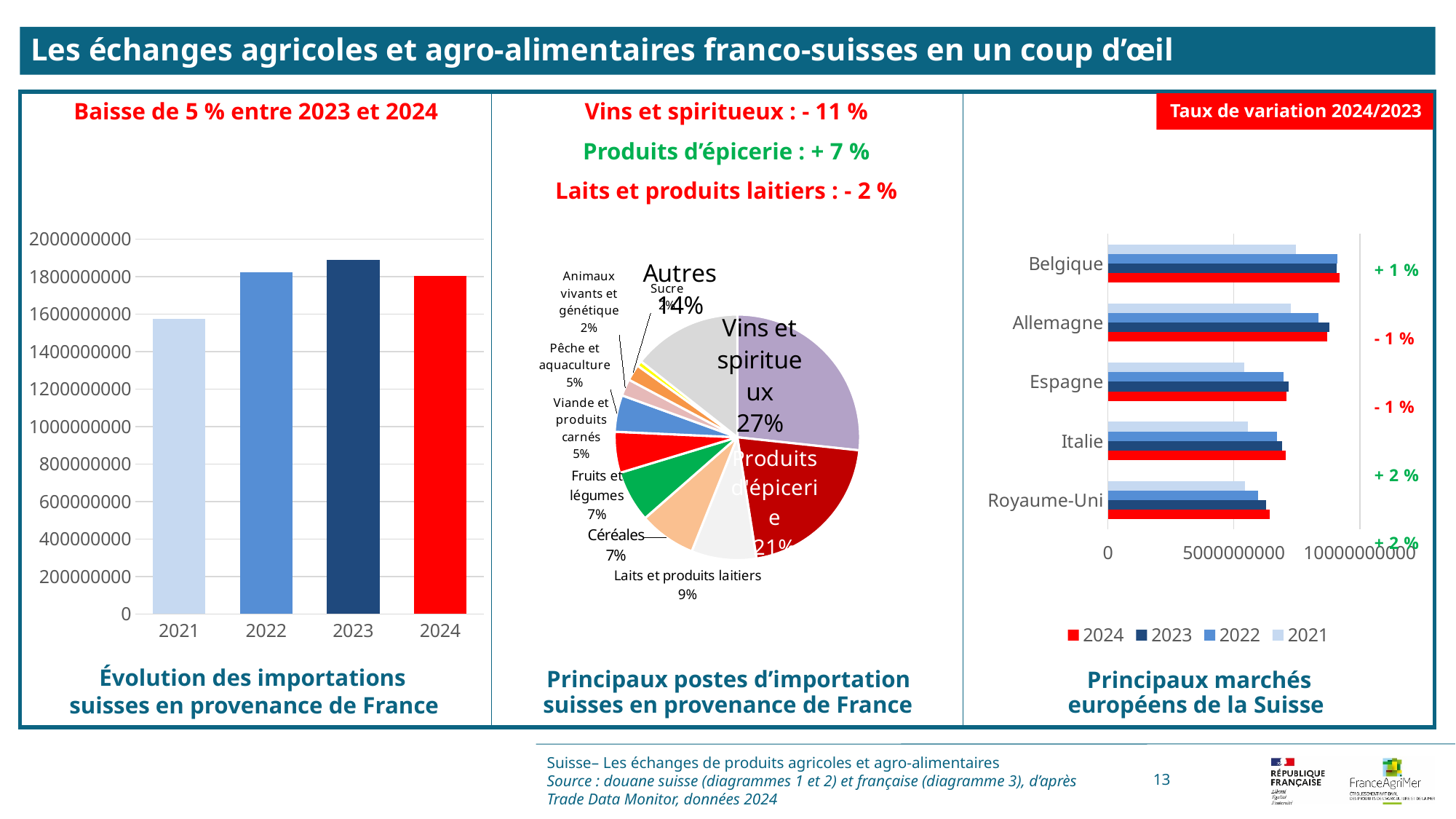
On the pie chart 'Principaux postes d'importation suisses en provenance de France', which slice is the largest? Vins et spiritueux On the chart 'Principaux marchés européens de la Suisse', is the 2024 value for Belgique greater or less than 5000000000? greater On the pie chart 'Principaux postes d'importation suisses en provenance de France', what share does 'Vins et spiritueux' have? 27% On the pie chart 'Principaux postes d'importation suisses en provenance de France', what is the difference between the shares of 'Vins et spiritueux' and 'Produits d'épicerie'? 6% On the chart 'Principaux marchés européens de la Suisse', how many series does the legend list? 4 On the chart 'Évolution des importations suisses en provenance de France', which year has the lowest bar? 2021 On the pie chart 'Principaux postes d'importation suisses en provenance de France', what share does 'Laits et produits laitiers' have? 9% On the chart 'Principaux marchés européens de la Suisse', which country has the longest bars? Belgique What kind of chart is 'Évolution des importations suisses en provenance de France'? bar chart On the chart 'Évolution des importations suisses en provenance de France', is the value for 2021 greater or less than 1600000000? less On the chart 'Évolution des importations suisses en provenance de France', how many years are plotted? 4 On the chart 'Évolution des importations suisses en provenance de France', which year has the highest bar? 2023